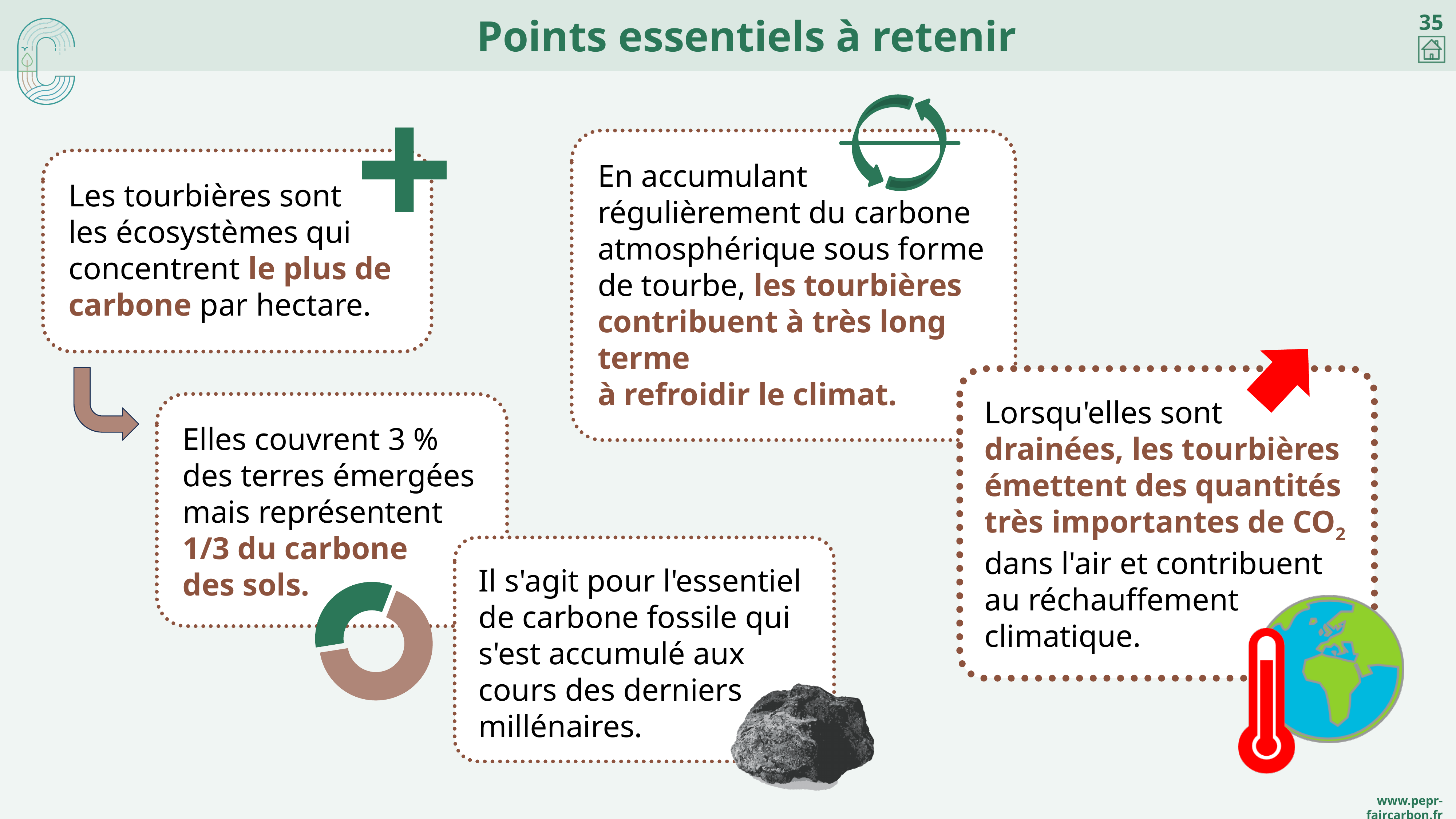
In the small donut chart, is the green slice greater or less than half of the ring? less In the small donut chart, which slice is larger, the green one or the brown one? the brown one What two colours are used for the slices of the small donut chart? green and brown How many slices does the small donut chart on the slide have? 2 What kind of chart is the small chart below the box about 3 % of land area? pie chart (donut) Does the small donut chart on the slide have a legend? No